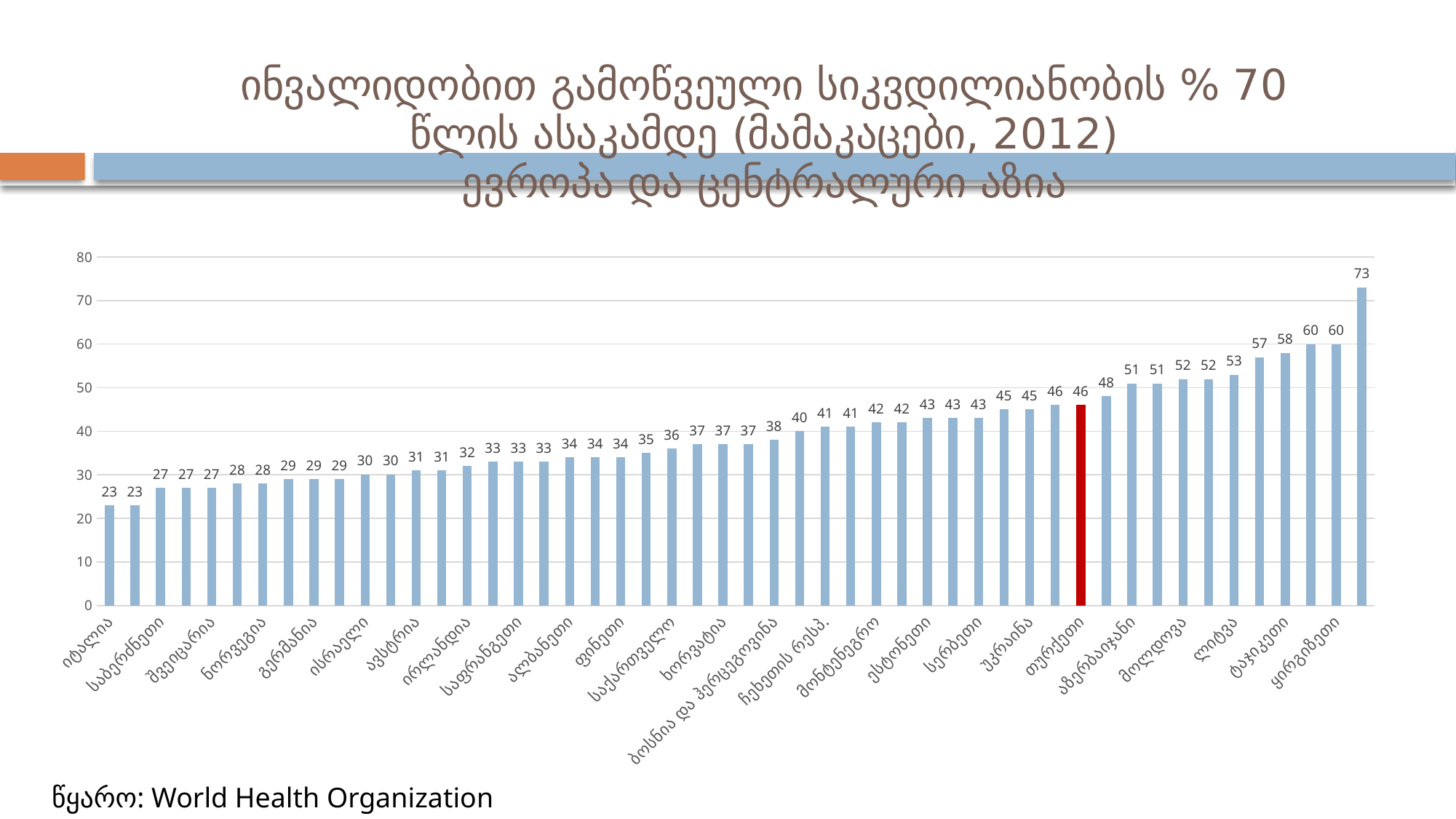
What is the value for იტალია? 23 What is the value of the red-highlighted bar? 46 Do the values rise or fall from left to right along the x axis? rise What is the value for აზერბაიჯანი? 51 What is the value for ნორვეგია? 28 What is the difference between the value for აზერბაიჯანი and the value for იტალია? 28 Which is larger, the value for იტალია or the value for აზერბაიჯანი? აზერბაიჯანი What is the value for მოლდოვა? 52 What source is cited at the bottom of the slide? World Health Organization What is the highest value shown in the chart? 73 What kind of chart is shown on the slide? bar chart What is the lowest value shown in the chart? 23